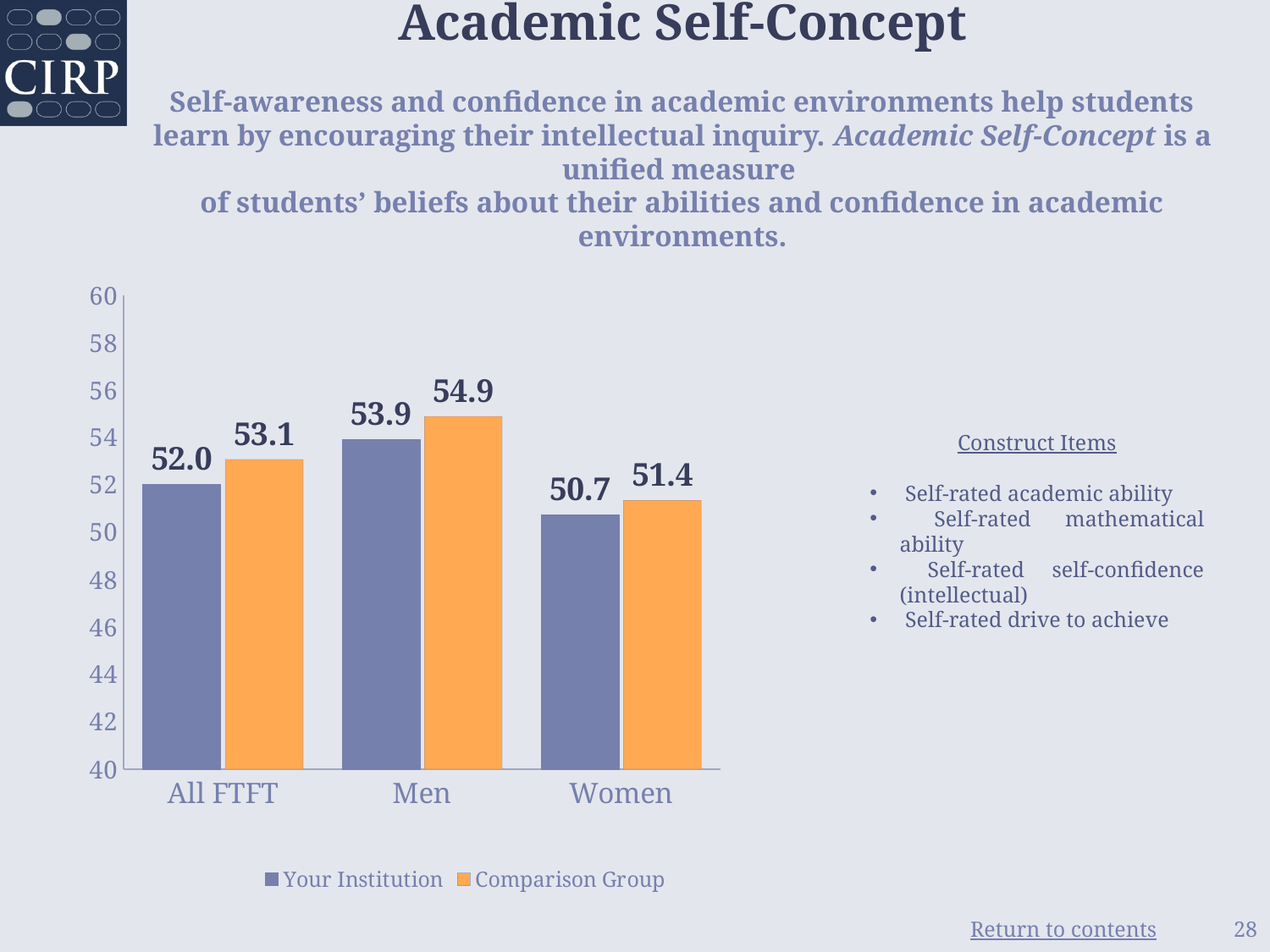
Is the value for Your Institution in the Women category greater or less than 52? less What is the value for the Comparison Group in the Women category? 51.4 Which category has the highest value for the Comparison Group? Men What is the difference between the Men and Women values for Your Institution? 3.2 What kind of chart is shown on the slide? Bar chart How many categories are shown on the x axis? 3 What is the difference between the Comparison Group and Your Institution values for All FTFT? 1.1 Which is larger for Men: Your Institution or the Comparison Group? Comparison Group What is the value for Your Institution in the All FTFT category? 52.0 What is the value for Your Institution in the Men category? 53.9 Which category has the lowest value for Your Institution? Women How many series does the legend list? 2